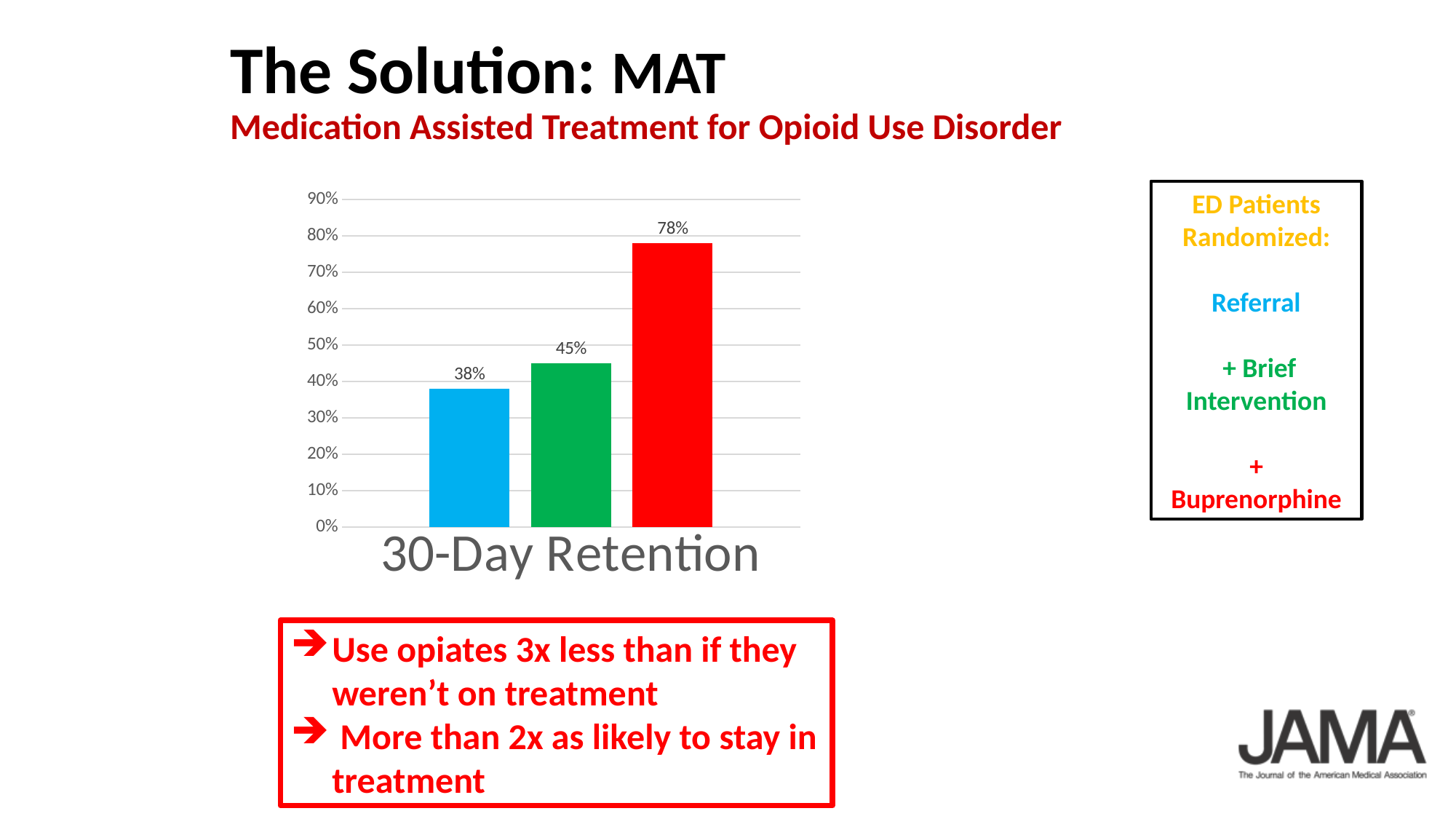
Which group has the lowest 30-day retention? Referral Is the 30-day retention for + Buprenorphine greater or less than 70%? greater What is the difference in 30-day retention between the green bar (+ Brief Intervention) and the blue bar (Referral)? 7% What is the 30-day retention value for the blue bar (Referral)? 38% Which group has the highest 30-day retention? + Buprenorphine What is the 30-day retention value for the red bar (+ Buprenorphine)? 78% What is the label shown beneath the bars on the x axis? 30-Day Retention How many bars are shown in the 30-Day Retention chart? 3 What is the difference in 30-day retention between the red bar (+ Buprenorphine) and the blue bar (Referral)? 40% What is the 30-day retention value for the green bar (+ Brief Intervention)? 45% What kind of chart is used to show 30-Day Retention? bar chart Which is larger, the 30-day retention for + Brief Intervention or for Referral? + Brief Intervention